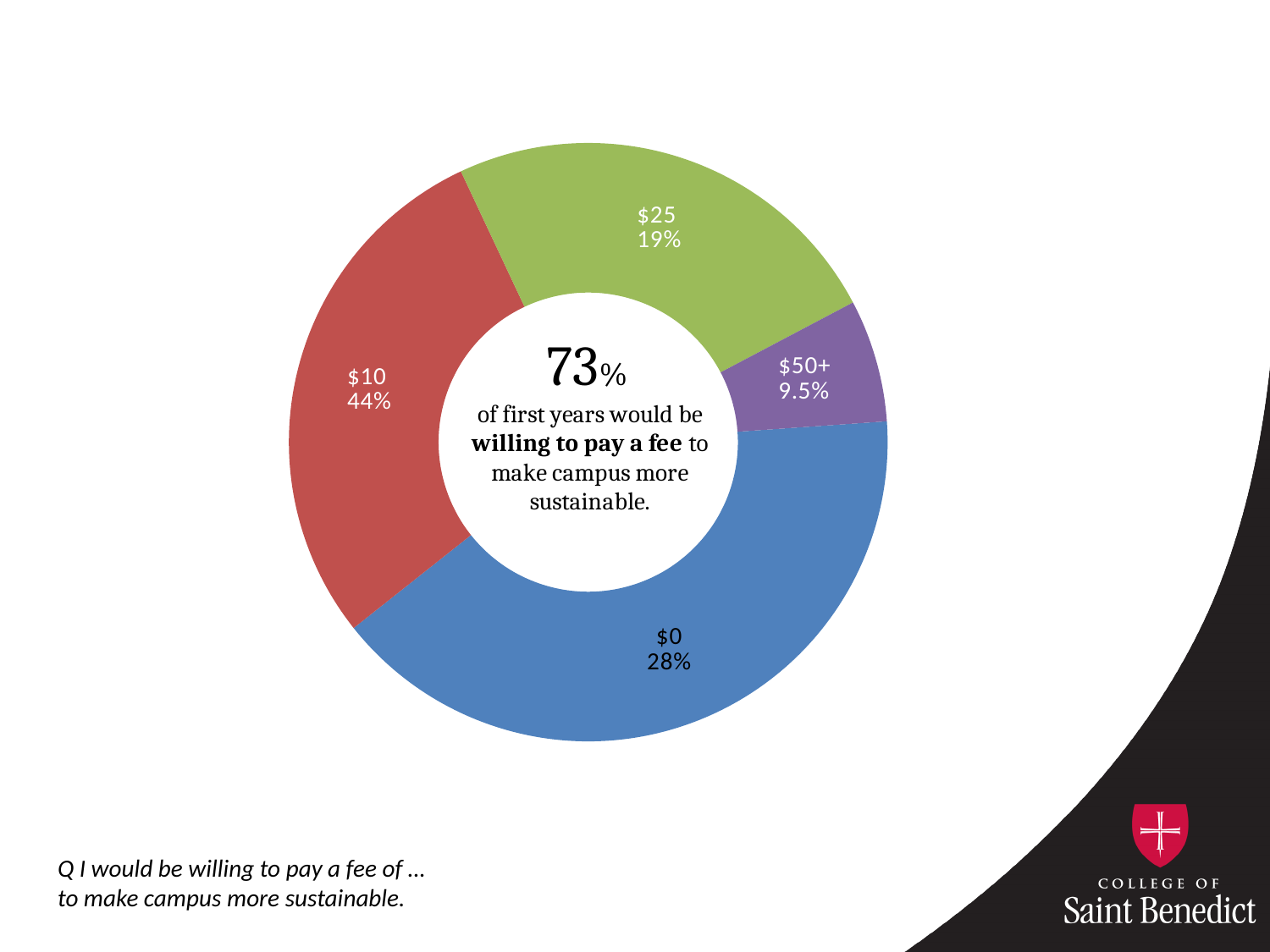
What colour is the $10 segment of the chart? Red What share of first years would be willing to pay a fee of $50+? 9.5% What kind of chart is shown on the slide? Pie chart (doughnut) Which fee amount has the smallest share of the chart? $50+ What share of first years would be willing to pay a fee of $10? 44% What share of first years would be willing to pay a fee of $25? 19% What percentage is printed in the centre of the chart? 73% How many fee categories are shown in the chart? 4 What share of first years chose $0? 28% Which fee amount has the largest share of the chart? $10 Which is larger, the share for $25 or the share for $0? $0 What is the difference in percentage points between the $10 share and the $0 share? 16